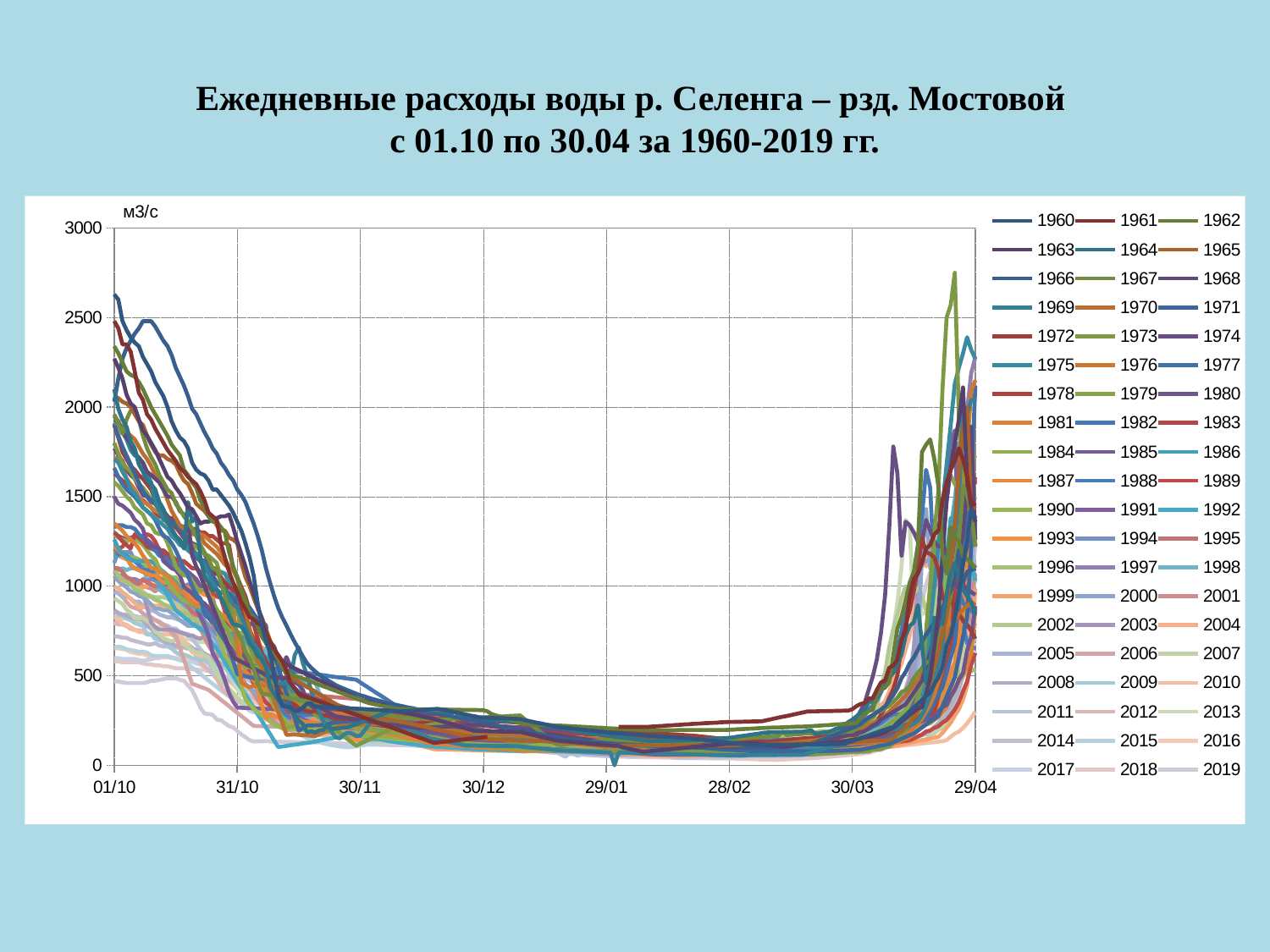
What kind of chart is shown on the slide? line chart What is the first date label on the horizontal axis? 01/10 Do the values generally rise or fall between 30/03 and 29/04? rise What is the highest tick value on the vertical axis? 3000 What unit is shown on the vertical axis? м3/с What is the last date label on the horizontal axis? 29/04 How many series does the legend list? 60 What is the first year listed in the legend? 1960 How many date labels are shown on the horizontal axis? 8 Is the highest value reached near 29/04 greater or less than 2500? greater What is the last year listed in the legend? 2019 Do the values generally rise or fall between 01/10 and 30/12? fall